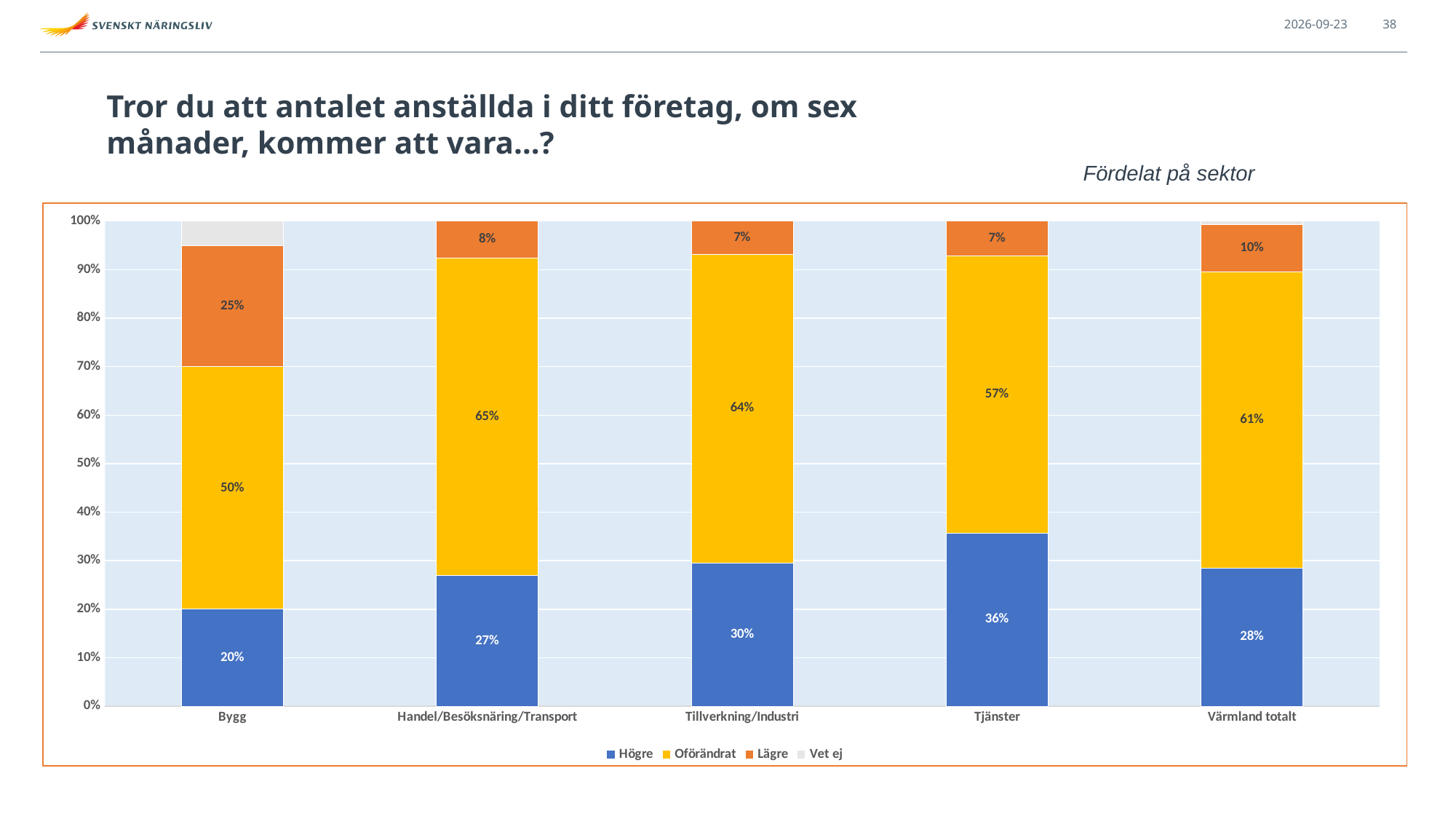
Which sector has the highest Högre value? Tjänster How many series does the legend list? 4 What is the Lägre value for Bygg? 25% What is the Lägre value for Värmland totalt? 10% Which is larger, the Oförändrat value for Tillverkning/Industri or for Tjänster? Tillverkning/Industri Which legend entry is shown in light grey? Vet ej What is the difference between the Högre values for Tjänster and Bygg? 16% What is the Högre value for Tjänster? 36% What is the Oförändrat value for Handel/Besöksnäring/Transport? 65% How many sectors (categories) are shown on the x axis? 5 What kind of chart is shown on the slide? stacked bar chart Which sector has the lowest Oförändrat value? Bygg